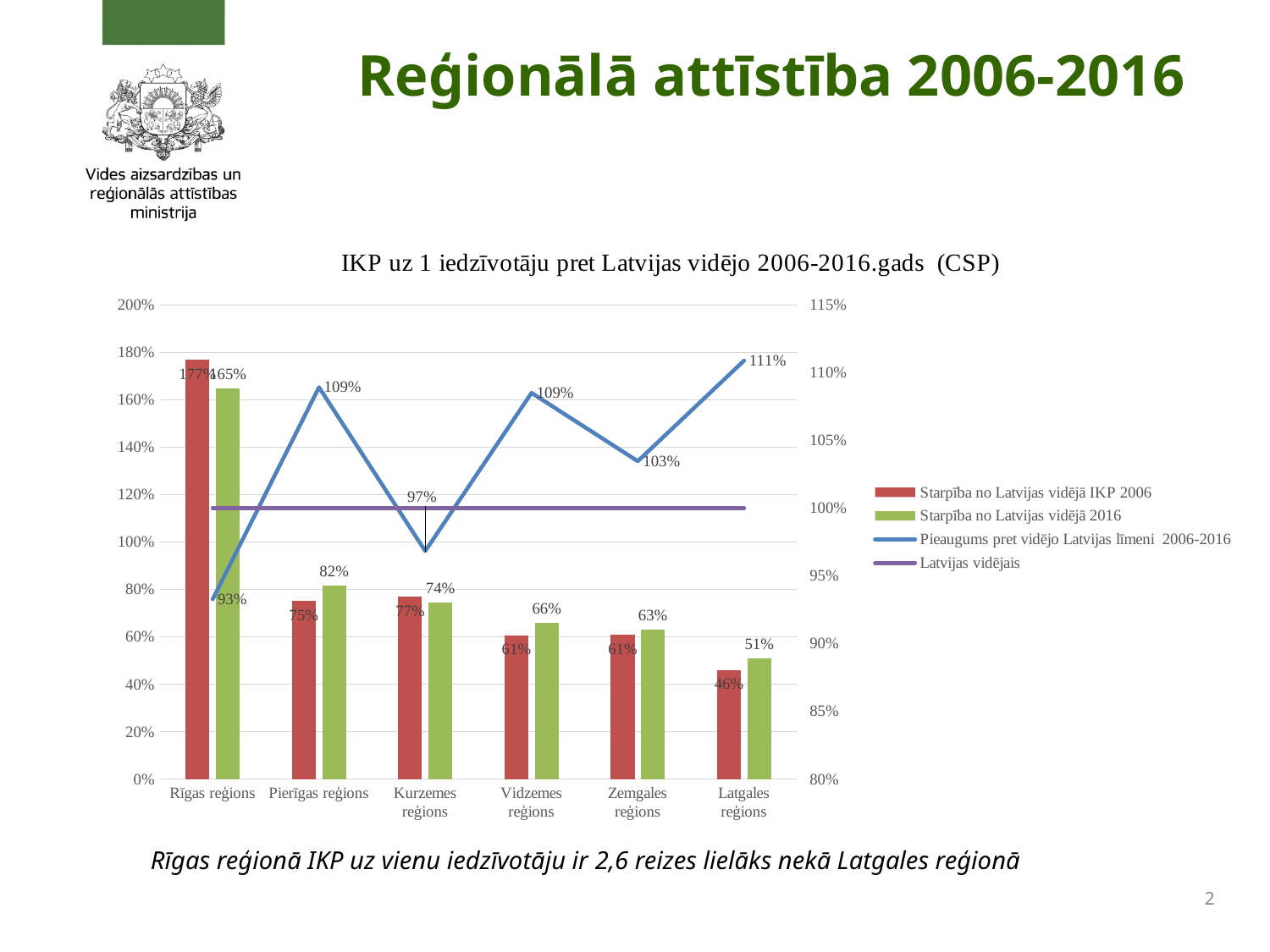
How many series does the legend list? 4 For Kurzemes reģions, which is larger: the 2006 value or the 2016 value? 2006 value (77%) Which region has the highest value on the 'Pieaugums pret vidējo Latvijas līmeni 2006-2016' line? Latgales reģions How many regions are shown on the x axis? 6 Which region has the highest value for 'Starpība no Latvijas vidējā 2016'? Rīgas reģions What is the value of 'Pieaugums pret vidējo Latvijas līmeni 2006-2016' for Kurzemes reģions? 97% What is the value of 'Starpība no Latvijas vidējā 2016' for Latgales reģions? 51% What kind of chart is this? Combined bar and line chart What is the value of 'Starpība no Latvijas vidējā IKP 2006' for Rīgas reģions? 177% Which region has the lowest value for 'Starpība no Latvijas vidējā IKP 2006'? Latgales reģions What is the title of the chart? IKP uz 1 iedzīvotāju pret Latvijas vidējo 2006-2016.gads (CSP) What is the difference between the 2016 and 2006 values for Pierīgas reģions? 7%